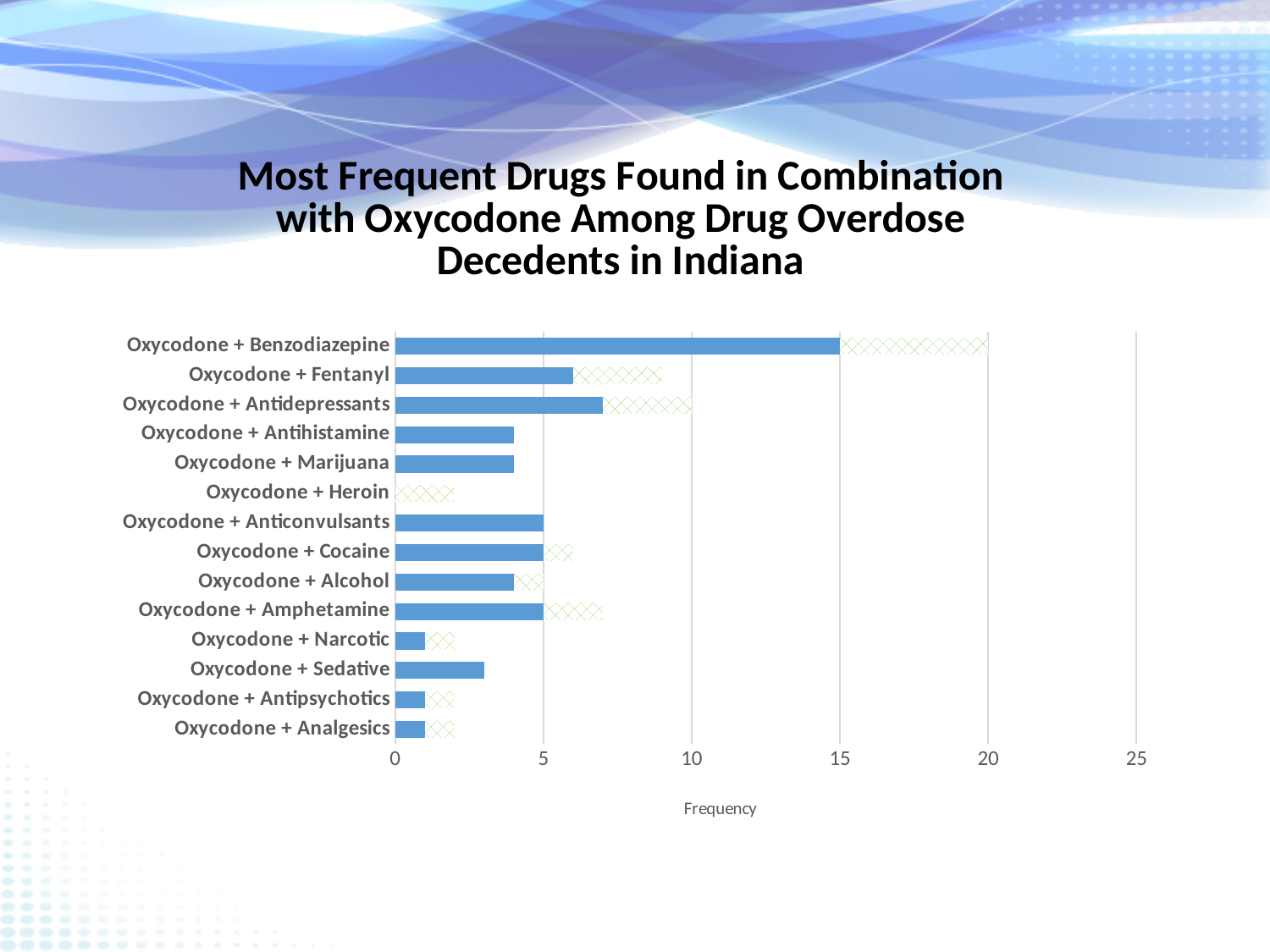
What is the total length of the bar for Oxycodone + Alcohol, including the hatched segment? 5 Which drug combination has the longest bar on the chart? Oxycodone + Benzodiazepine What is the label on the horizontal axis of the chart? Frequency What is the title of the chart? Most Frequent Drugs Found in Combination with Oxycodone Among Drug Overdose Decedents in Indiana How many drug combination categories are listed on the chart? 14 Which has a longer bar, Oxycodone + Benzodiazepine or Oxycodone + Antidepressants? Oxycodone + Benzodiazepine Is the total bar length for Oxycodone + Fentanyl greater or less than 10? less Is the value for Oxycodone + Sedative greater or less than 5? less What is the total length of the bar for Oxycodone + Benzodiazepine, including the hatched segment? 20 What is the total length of the bar for Oxycodone + Antidepressants, including the hatched segment? 10 What kind of chart is shown on the slide? bar chart What is the frequency shown for Oxycodone + Anticonvulsants? 5